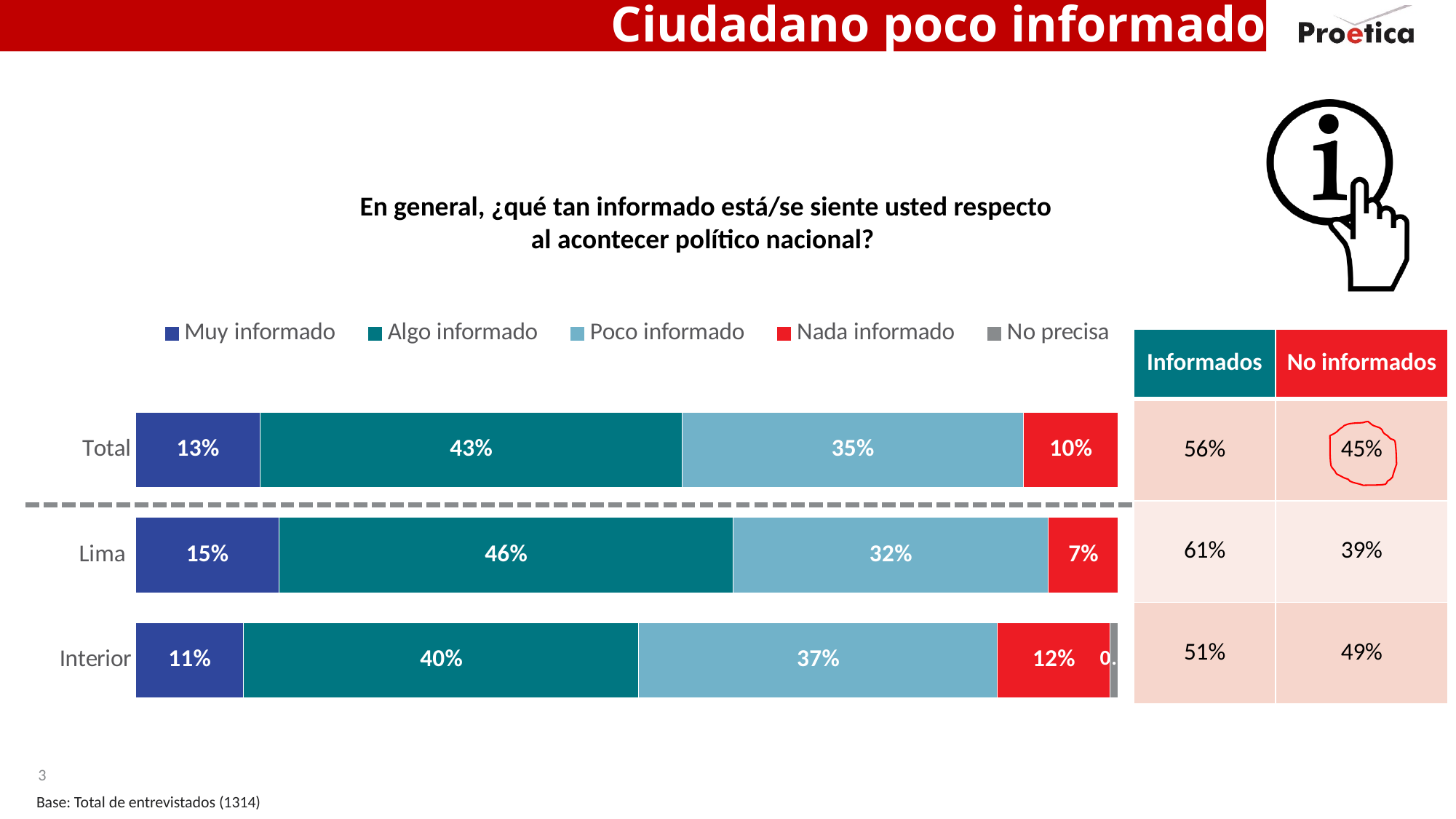
Is the 'Poco informado' value larger for Lima or for Interior? Interior What kind of chart is shown on the slide? Stacked bar chart Which category has the highest 'Nada informado' value? Interior What is the 'Nada informado' value for Total? 10% How many categories (bars) are shown in the chart? 3 Which category has the lowest 'Muy informado' value? Interior Which legend entry is shown in red? Nada informado What percentage of respondents in Lima are 'Algo informado'? 46% What is the 'Poco informado' value for the Interior bar? 37% What is the 'Muy informado' value for Lima? 15% What is the difference between the 'Algo informado' values for Lima and Interior? 6% How many series does the legend list? 5